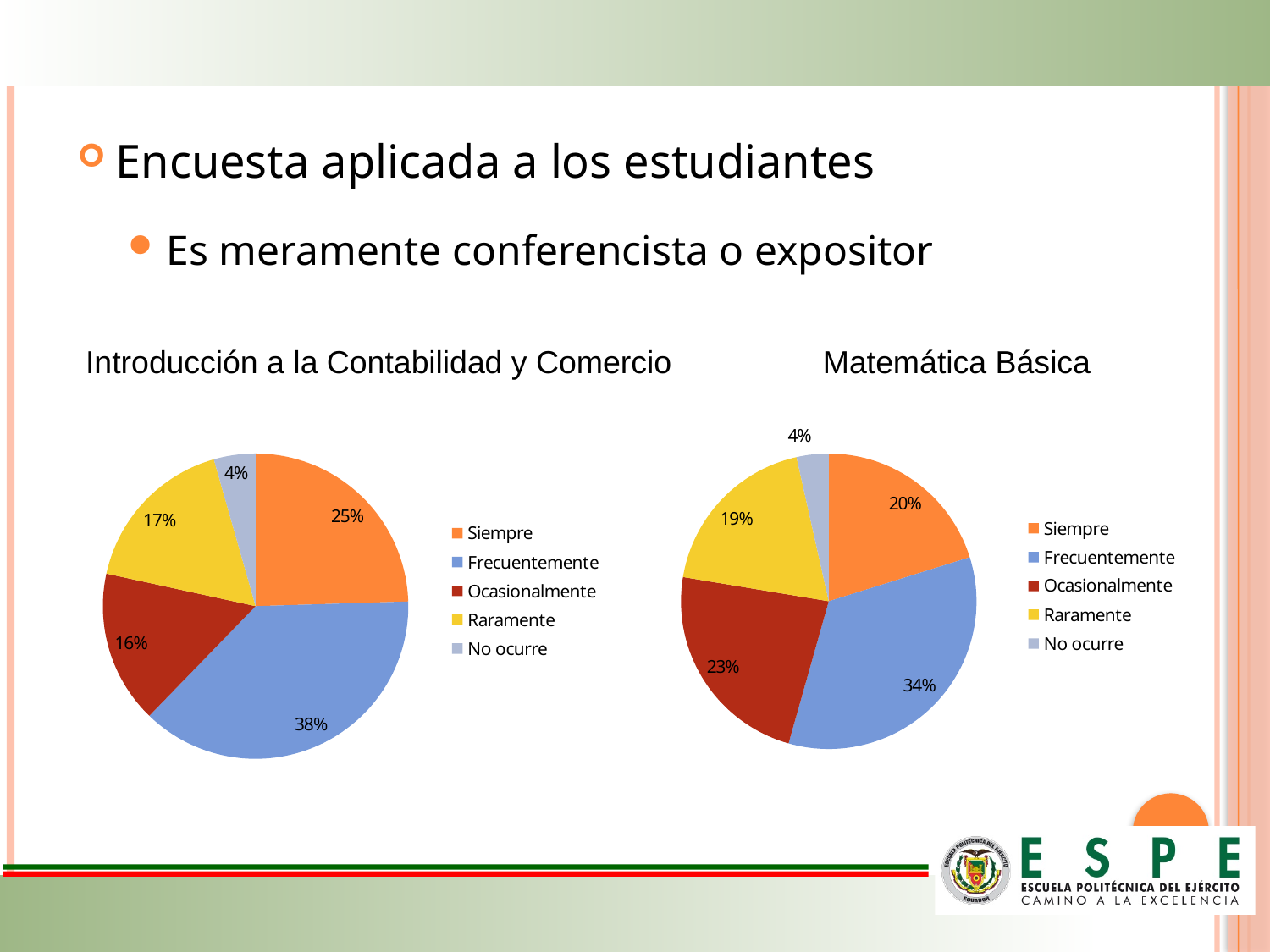
In the 'Matemática Básica' chart, what share does Raramente have? 19% In the 'Introducción a la Contabilidad y Comercio' chart, what colour is the Frecuentemente slice? Blue In the 'Introducción a la Contabilidad y Comercio' chart, what share does Siempre have? 25% In the 'Introducción a la Contabilidad y Comercio' chart, which category has the smallest share? No ocurre How many entries does the legend of the 'Introducción a la Contabilidad y Comercio' chart list? 5 In the 'Matemática Básica' chart, which category has the largest share? Frecuentemente What type of chart is used for 'Matemática Básica'? Pie chart In the 'Introducción a la Contabilidad y Comercio' chart, what share does Frecuentemente have? 38% In the 'Matemática Básica' chart, what share does Ocasionalmente have? 23% How many slices does the 'Matemática Básica' pie chart have? 5 In the 'Matemática Básica' chart, what is the difference between the Frecuentemente and Siempre shares? 14% In the 'Introducción a la Contabilidad y Comercio' chart, which is larger: Siempre or Ocasionalmente? Siempre